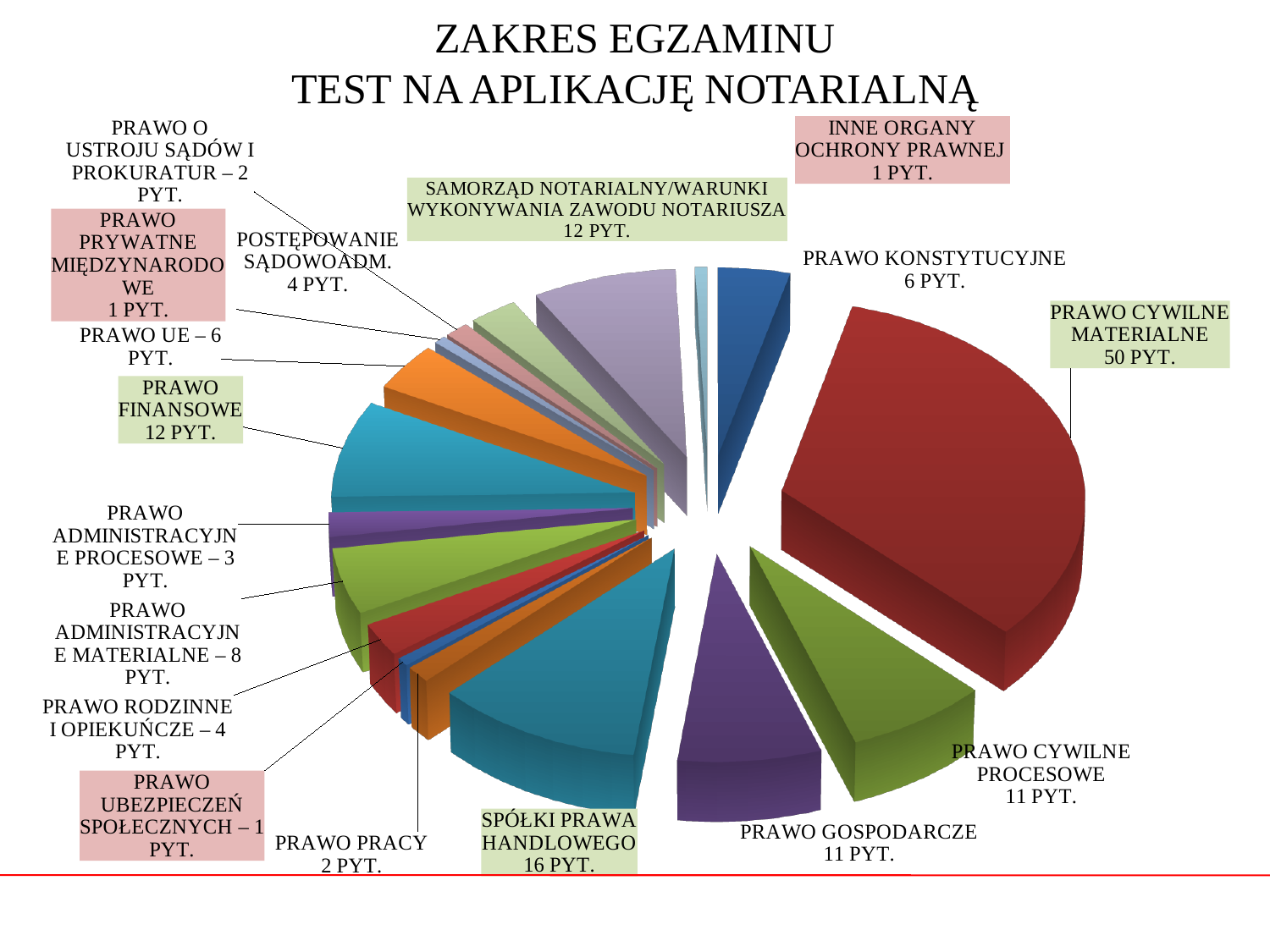
Which category has the largest number of questions? PRAWO CYWILNE MATERIALNE How many questions are shown for PRAWO ADMINISTRACYJNE MATERIALNE? 8 PYT. How many questions are shown for SPÓŁKI PRAWA HANDLOWEGO? 16 PYT. What is the difference in the number of questions between PRAWO FINANSOWE and PRAWO UE? 6 What is the difference in the number of questions between PRAWO CYWILNE MATERIALNE and SPÓŁKI PRAWA HANDLOWEGO? 34 What kind of chart is shown on the slide? Pie chart What is the title of the slide containing the chart? ZAKRES EGZAMINU TEST NA APLIKACJĘ NOTARIALNĄ How many questions are shown for PRAWO KONSTYTUCYJNE? 6 PYT. How many questions are shown for SAMORZĄD NOTARIALNY/WARUNKI WYKONYWANIA ZAWODU NOTARIUSZA? 12 PYT. How many categories are labelled on the pie chart? 17 Which has more questions, SPÓŁKI PRAWA HANDLOWEGO or PRAWO FINANSOWE? SPÓŁKI PRAWA HANDLOWEGO How many questions (PYT.) are shown for PRAWO CYWILNE MATERIALNE? 50 PYT.